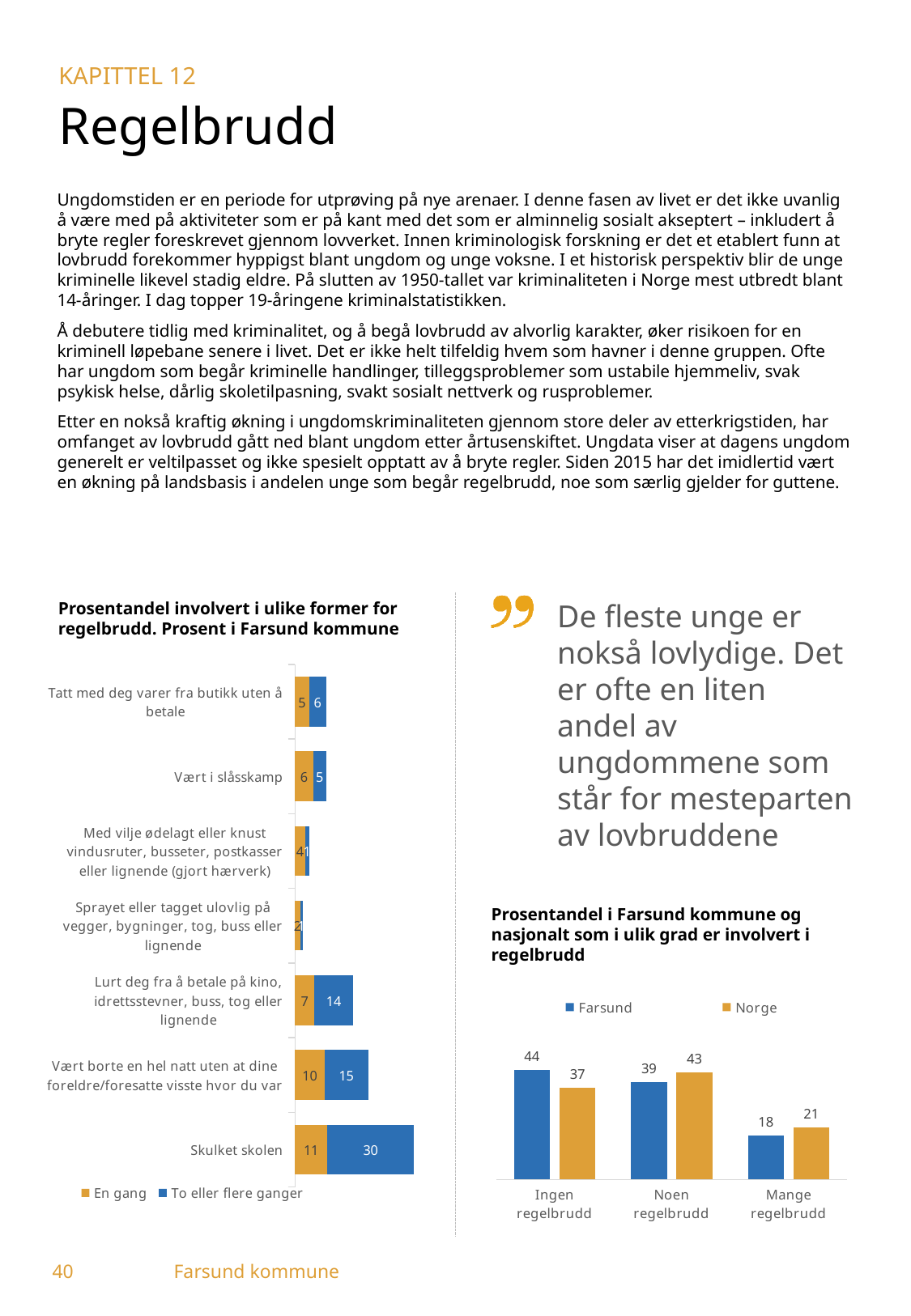
In the chart 'Prosentandel i Farsund kommune og nasjonalt som i ulik grad er involvert i regelbrudd', what is the value for Norge in the category 'Mange regelbrudd'? 21 In the chart 'Prosentandel i Farsund kommune og nasjonalt som i ulik grad er involvert i regelbrudd', how many series does the legend list? 2 In the chart 'Prosentandel involvert i ulike former for regelbrudd. Prosent i Farsund kommune', what is the value of 'En gang' for 'Vært borte en hel natt uten at dine foreldre/foresatte visste hvor du var'? 10 In the chart 'Prosentandel i Farsund kommune og nasjonalt som i ulik grad er involvert i regelbrudd', what is the difference between Farsund and Norge for 'Noen regelbrudd'? 4 In the chart 'Prosentandel involvert i ulike former for regelbrudd. Prosent i Farsund kommune', what is the total of the stacked bar for 'Lurt deg fra å betale på kino, idrettsstevner, buss, tog eller lignende'? 21 What kind of chart is 'Prosentandel involvert i ulike former for regelbrudd. Prosent i Farsund kommune'? Stacked bar chart In the chart 'Prosentandel involvert i ulike former for regelbrudd. Prosent i Farsund kommune', which category has the highest total? Skulket skolen In the chart 'Prosentandel i Farsund kommune og nasjonalt som i ulik grad er involvert i regelbrudd', what is the value for Farsund in the category 'Ingen regelbrudd'? 44 In the chart 'Prosentandel involvert i ulike former for regelbrudd. Prosent i Farsund kommune', how many categories are shown? 7 In the chart 'Prosentandel i Farsund kommune og nasjonalt som i ulik grad er involvert i regelbrudd', is the value for Farsund or Norge larger in 'Ingen regelbrudd'? Farsund In the chart 'Prosentandel involvert i ulike former for regelbrudd. Prosent i Farsund kommune', what is the value of 'To eller flere ganger' for 'Skulket skolen'? 30 In the chart 'Prosentandel i Farsund kommune og nasjonalt som i ulik grad er involvert i regelbrudd', which category has the lowest value for Farsund? Mange regelbrudd